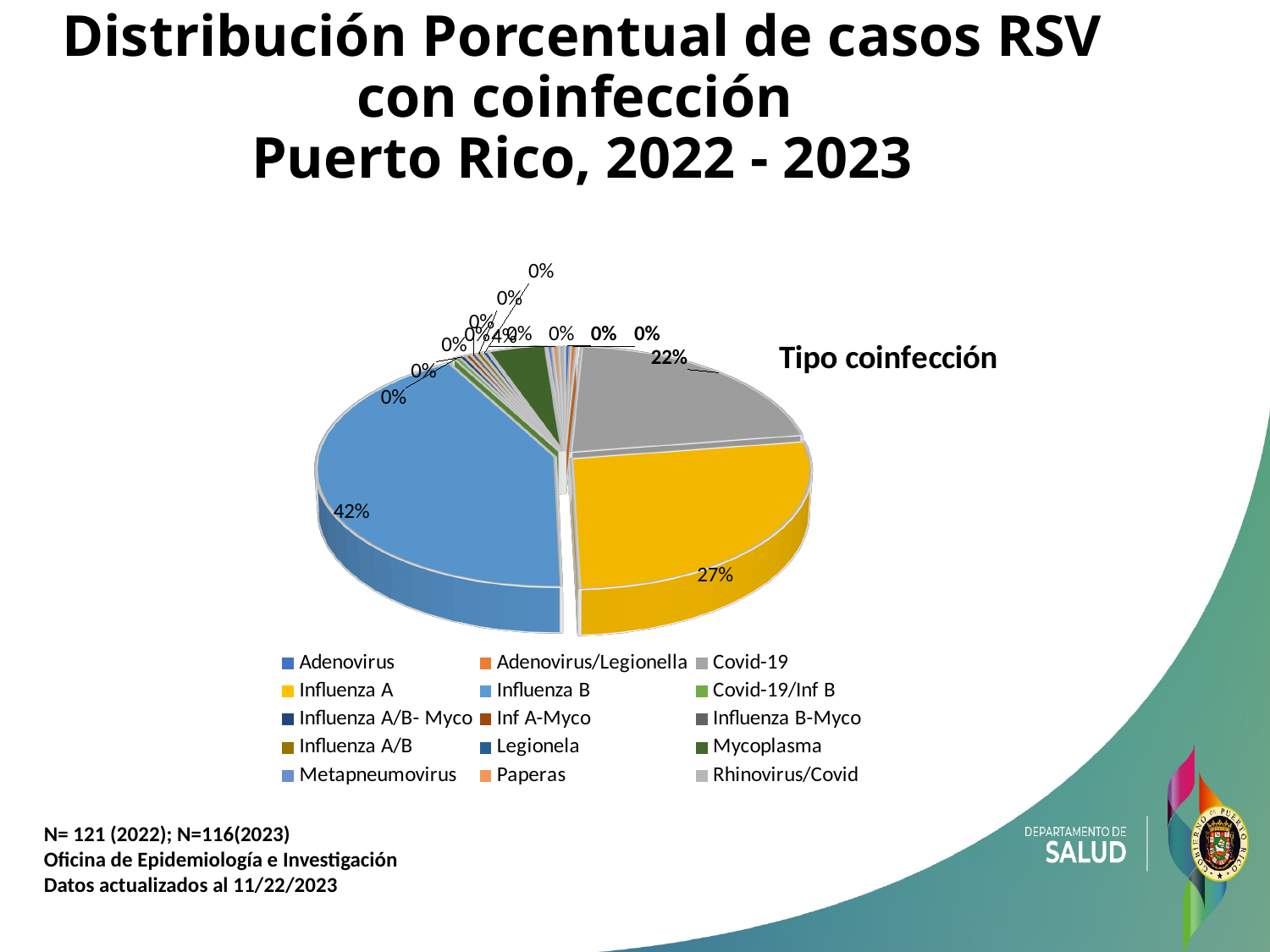
What is the title shown next to the pie chart? Tipo coinfección Which has a larger share, Influenza A or Covid-19? Influenza A Which coinfection type has the largest share of the pie? Influenza B What kind of chart is shown on the slide? Pie chart How many percentage points larger is the Influenza A share than the Covid-19 share? 5 percentage points What is the combined share of Influenza B, Influenza A and Covid-19? 91% How many percentage points larger is the Influenza B share than the Influenza A share? 15 percentage points What percentage of RSV coinfection cases is Influenza B? 42% What percentage of RSV coinfection cases is Mycoplasma? 4% What percentage of RSV coinfection cases is Covid-19? 22% How many coinfection types are listed in the legend? 15 What percentage of RSV coinfection cases is Influenza A? 27%